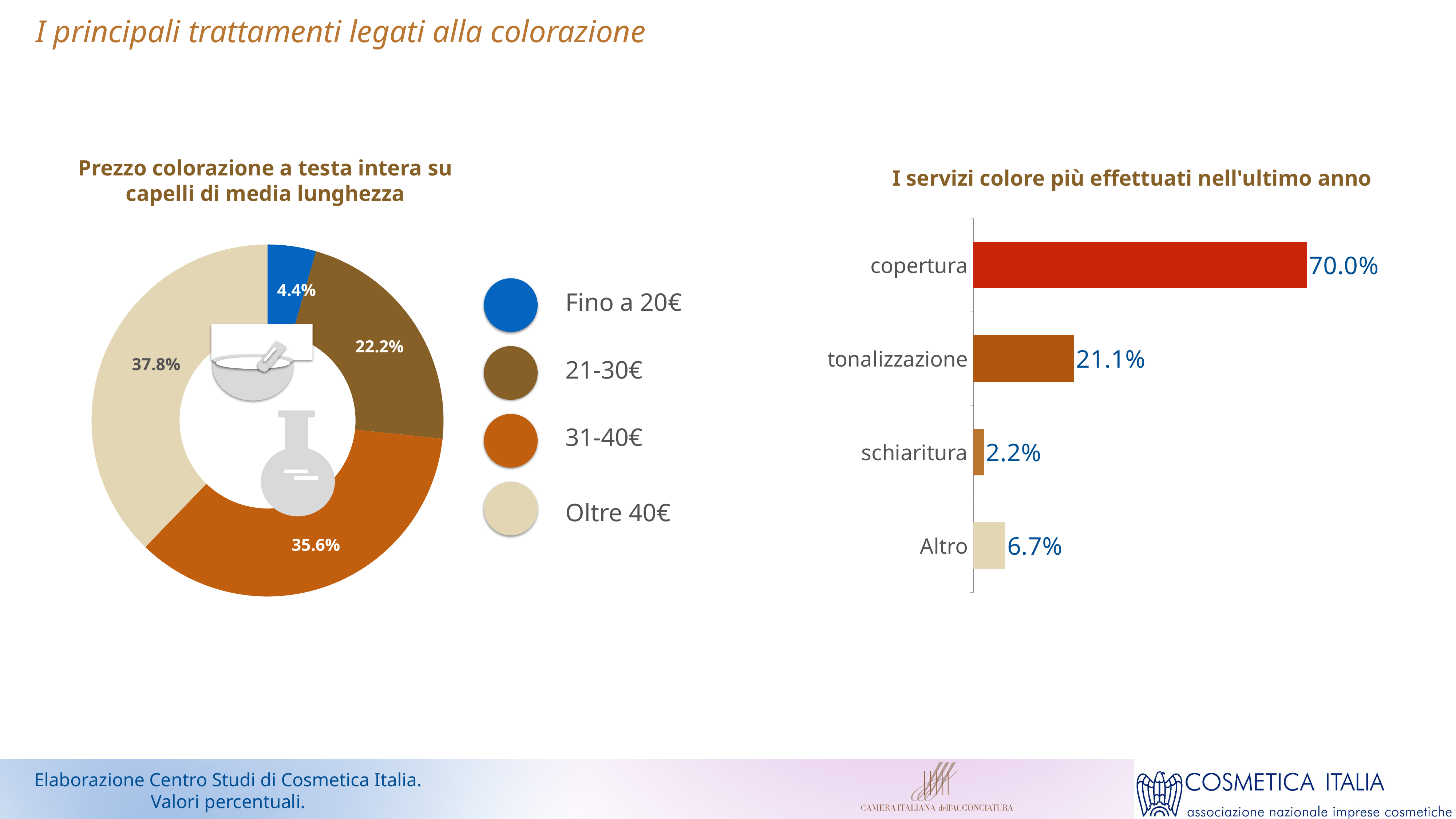
In the chart 'I servizi colore più effettuati nell'ultimo anno', which service has the lowest value? schiaritura In the chart 'Prezzo colorazione a testa intera su capelli di media lunghezza', which price band has the largest share? Oltre 40€ In the chart 'Prezzo colorazione a testa intera su capelli di media lunghezza', how many price bands does the legend list? 4 In the chart 'I servizi colore più effettuati nell'ultimo anno', what is the value for 'copertura'? 70.0% In the chart 'Prezzo colorazione a testa intera su capelli di media lunghezza', what is the share for 'Fino a 20€'? 4.4% In the chart 'Prezzo colorazione a testa intera su capelli di media lunghezza', what is the difference between the shares for '31-40€' and '21-30€'? 13.4% In the chart 'I servizi colore più effettuati nell'ultimo anno', what is the value for 'schiaritura'? 2.2% What kind of chart is 'I servizi colore più effettuati nell'ultimo anno'? Bar chart In the chart 'I servizi colore più effettuati nell'ultimo anno', what is the difference between 'copertura' and 'tonalizzazione'? 48.9% What kind of chart is 'Prezzo colorazione a testa intera su capelli di media lunghezza'? Doughnut chart In the chart 'Prezzo colorazione a testa intera su capelli di media lunghezza', what is the share for 'Oltre 40€'? 37.8% In the chart 'Prezzo colorazione a testa intera su capelli di media lunghezza', which price band has the smallest share? Fino a 20€